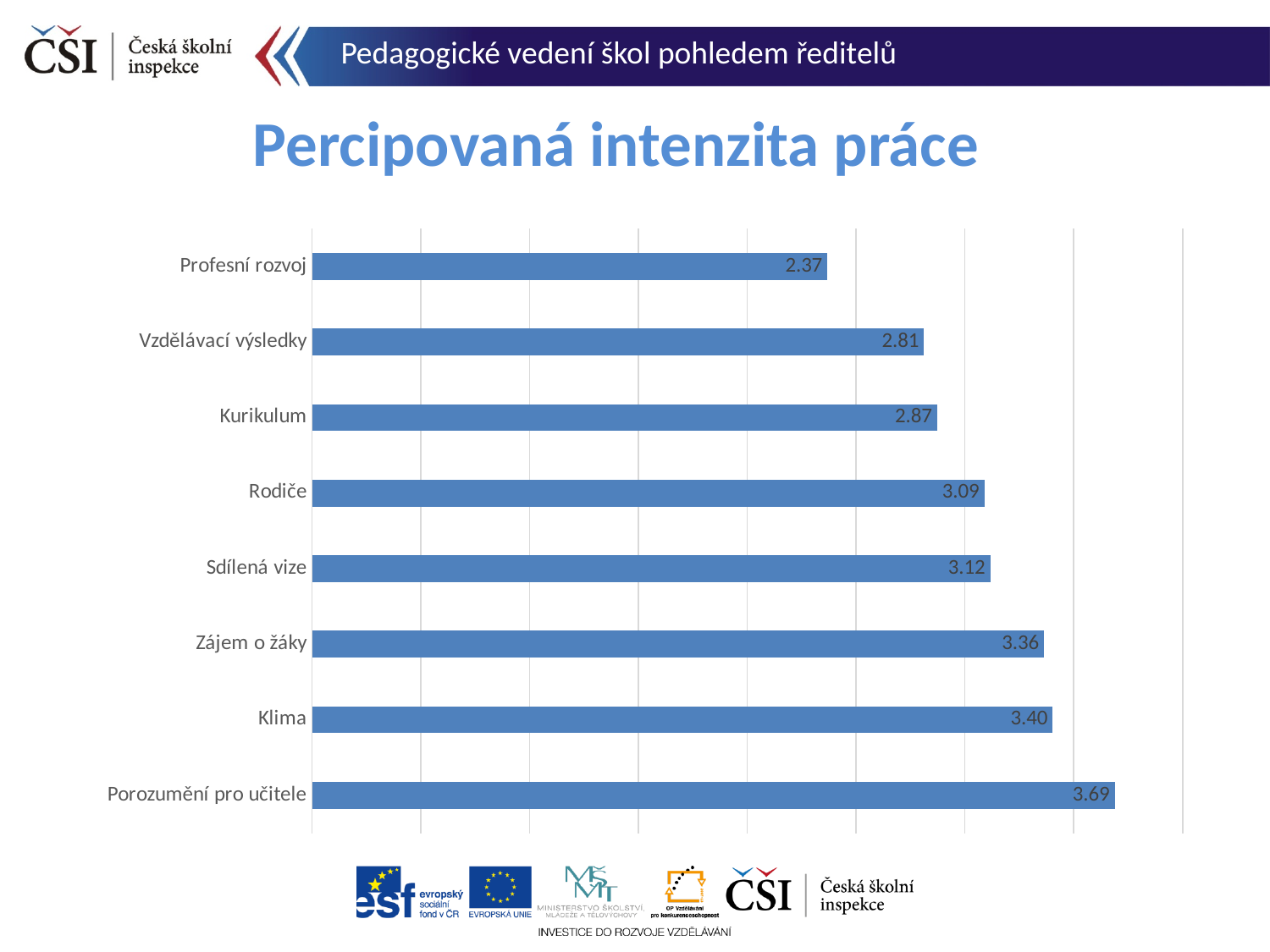
What kind of chart is shown on the slide? Bar chart What is the value for Kurikulum? 2.87 What is the title of the chart? Percipovaná intenzita práce Which category has the highest value? Porozumění pro učitele Which category has the lowest value? Profesní rozvoj What is the value for Profesní rozvoj? 2.37 What is the value for Klima? 3.40 What is the value for Sdílená vize? 3.12 What is the difference between the values for Porozumění pro učitele and Profesní rozvoj? 1.32 What is the difference between the values for Zájem o žáky and Rodiče? 0.27 Which has a larger value, Vzdělávací výsledky or Rodiče? Rodiče How many categories are shown in the chart? 8